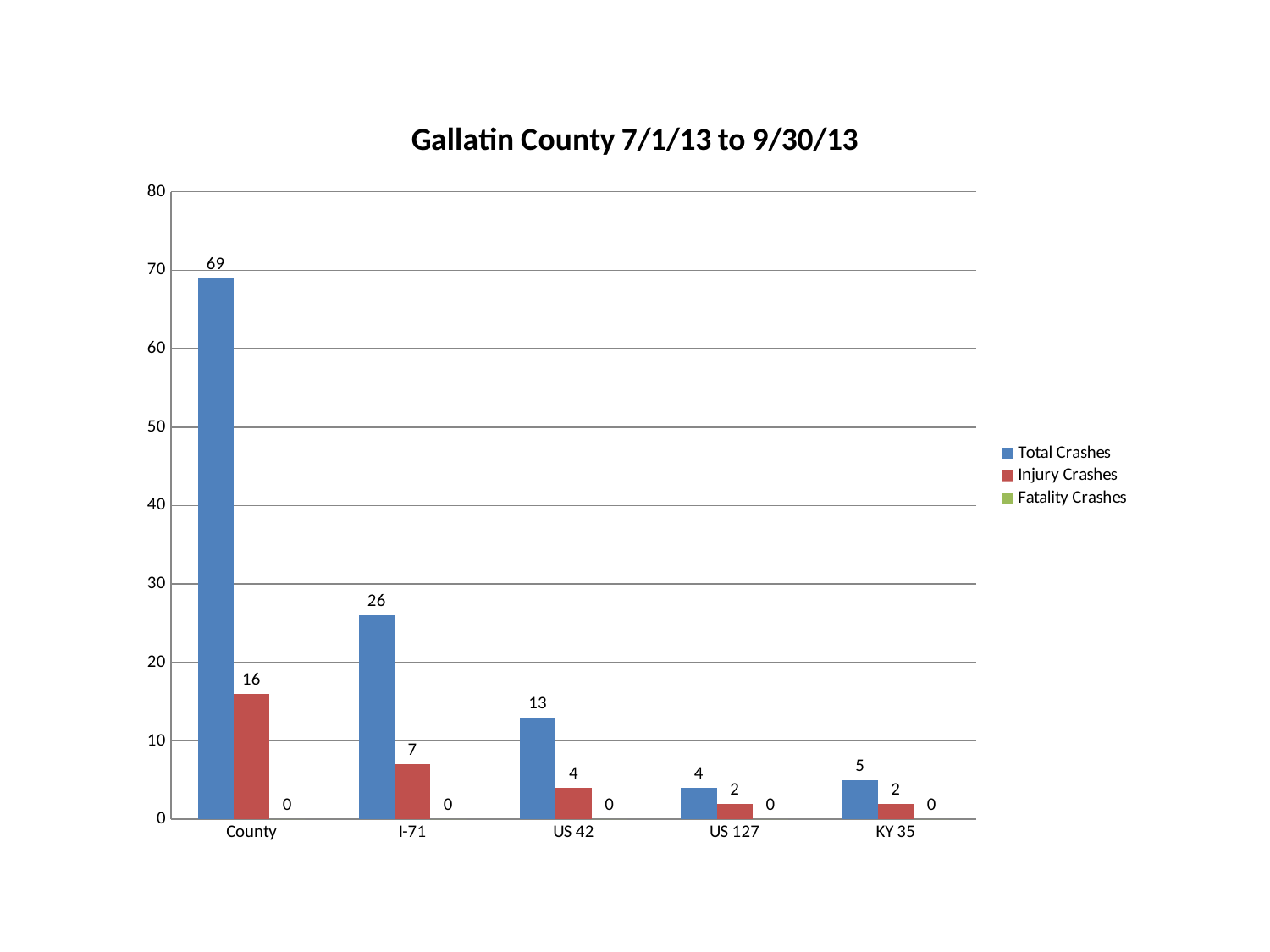
Is the value of Total Crashes for County greater or less than 60? greater What kind of chart is shown on the slide? bar chart What is the difference between Total Crashes and Injury Crashes for I-71? 19 What is the title of the chart? Gallatin County 7/1/13 to 9/30/13 How many categories are shown on the x axis? 5 Which category has the lowest Total Crashes value? US 127 Which is larger, Total Crashes for US 42 or Total Crashes for KY 35? US 42 What is the value of Total Crashes for County? 69 What is the value of Injury Crashes for I-71? 7 Which category has the highest Total Crashes value? County How many series does the legend list? 3 What is the value of Fatality Crashes for US 42? 0